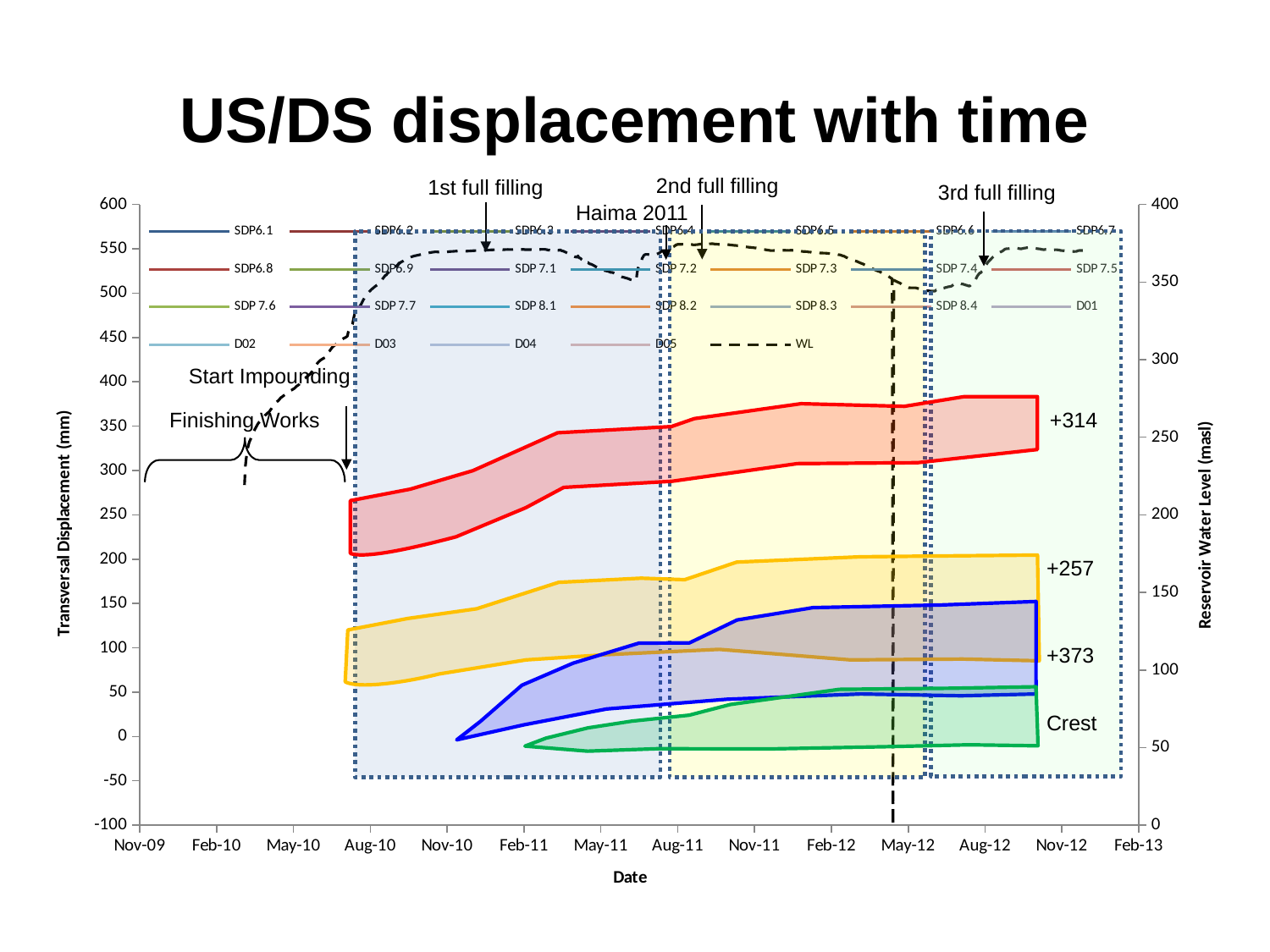
How many series does the legend list? 26 Is the green Crest band at Nov-12 greater or less than 100 mm? less What is the label of the right-hand vertical axis? Reservoir Water Level (masl) Does the red +314 band rise or fall from Aug-10 to Nov-12? rise Is the WL (water level) line at Nov-10 greater or less than 350 masl on the right axis? greater Which shaded band reaches the highest transversal displacement values? +314 At Nov-12, which band shows larger displacement, the red +314 band or the green Crest band? +314 What is the title of the chart? US/DS displacement with time Is the upper edge of the red +314 band at Nov-12 greater or less than 300 mm? greater What kind of chart is shown on the slide? line chart Which legend entry is drawn as a dashed line? WL Which shaded band has the lowest transversal displacement values? Crest